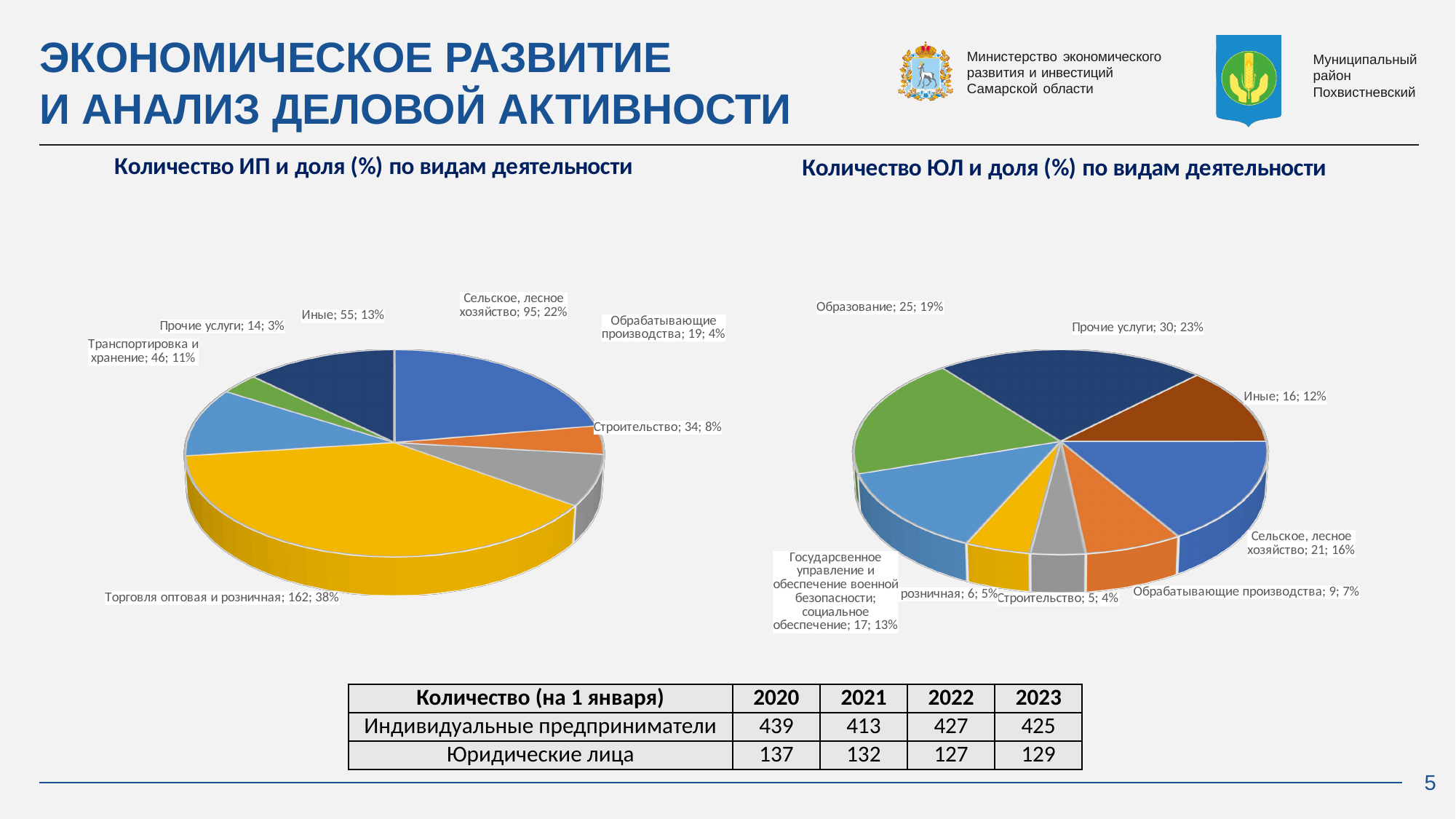
On the right chart (Количество ЮЛ и доля (%) по видам деятельности), how many legal entities are in Прочие услуги? 30 On the left chart (Количество ИП и доля (%) по видам деятельности), which category has the smallest value? Прочие услуги What type of chart is used on the left side of the slide? Pie chart On the left chart (Количество ИП и доля (%) по видам деятельности), how many categories are shown? 7 On the right chart (Количество ЮЛ и доля (%) по видам деятельности), what share does Образование have? 19% On the right chart (Количество ЮЛ и доля (%) по видам деятельности), what is the difference between Образование and Обрабатывающие производства? 16 On the right chart (Количество ЮЛ и доля (%) по видам деятельности), which is larger: Сельское, лесное хозяйство or Иные? Сельское, лесное хозяйство On the right chart (Количество ЮЛ и доля (%) по видам деятельности), which category has the smallest value? Строительство On the left chart (Количество ИП и доля (%) по видам деятельности), what share does Сельское, лесное хозяйство have? 22% On the left chart (Количество ИП и доля (%) по видам деятельности), which category has the largest value? Торговля оптовая и розничная On the left chart (Количество ИП и доля (%) по видам деятельности), how many individual entrepreneurs are in Торговля оптовая и розничная? 162 On the left chart (Количество ИП и доля (%) по видам деятельности), what is the difference between Иные and Транспортировка и хранение? 9